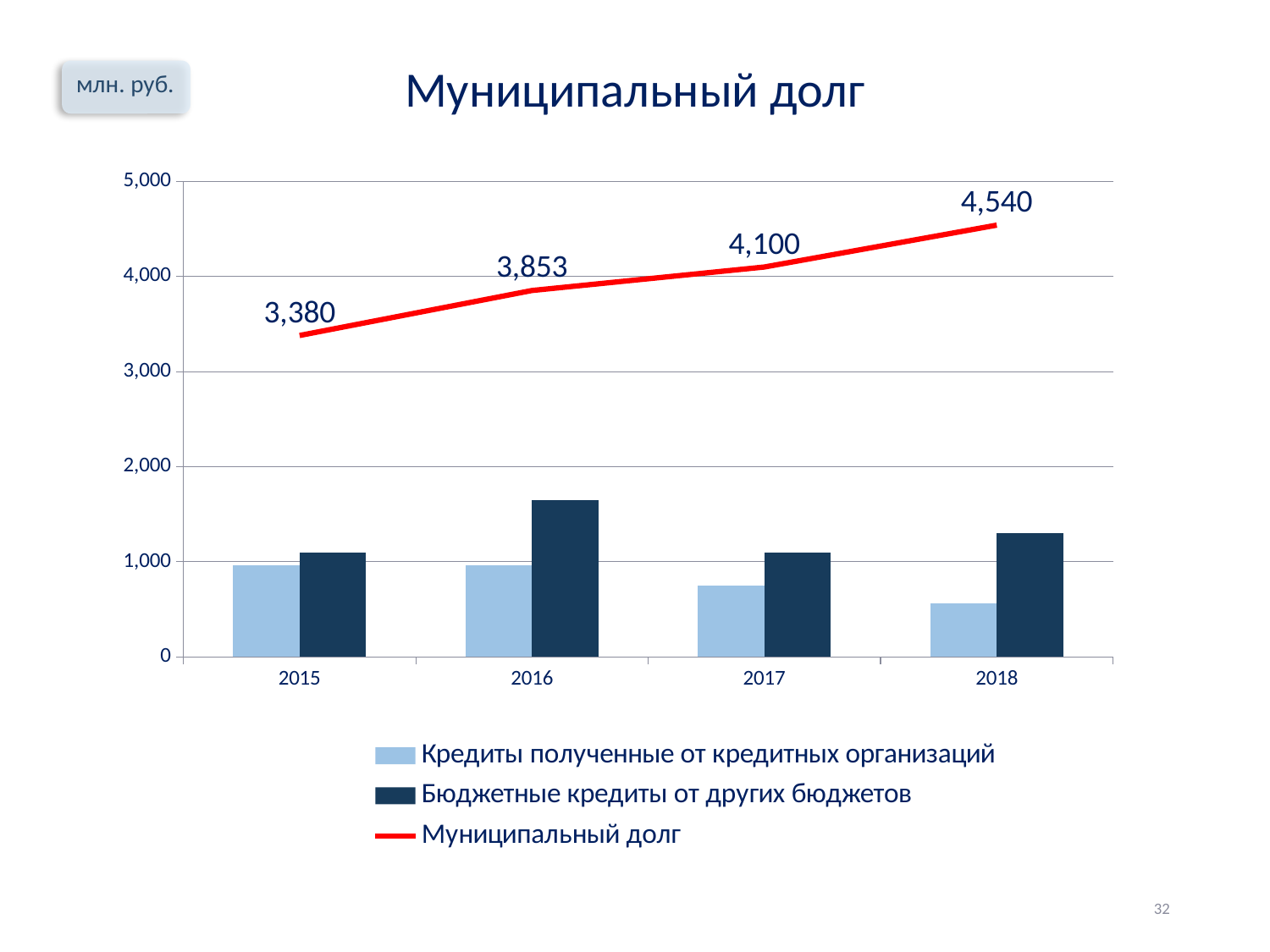
Does Муниципальный долг rise or fall from 2015 to 2018? rise Is the value for Бюджетные кредиты от других бюджетов in 2016 greater or less than 1,000? greater What is the value of Муниципальный долг in 2015? 3,380 Is the value for Кредиты полученные от кредитных организаций in 2018 greater or less than 1,000? less In which year is Муниципальный долг the highest? 2018 What is the value of Муниципальный долг in 2018? 4,540 How many series does the legend list? 3 In which year is the bar for Бюджетные кредиты от других бюджетов the tallest? 2016 How many years are shown on the x axis? 4 What is the value of Муниципальный долг in 2016? 3,853 By how much did Муниципальный долг increase from 2015 to 2018? 1,160 What is the difference in Муниципальный долг between 2017 and 2016? 247